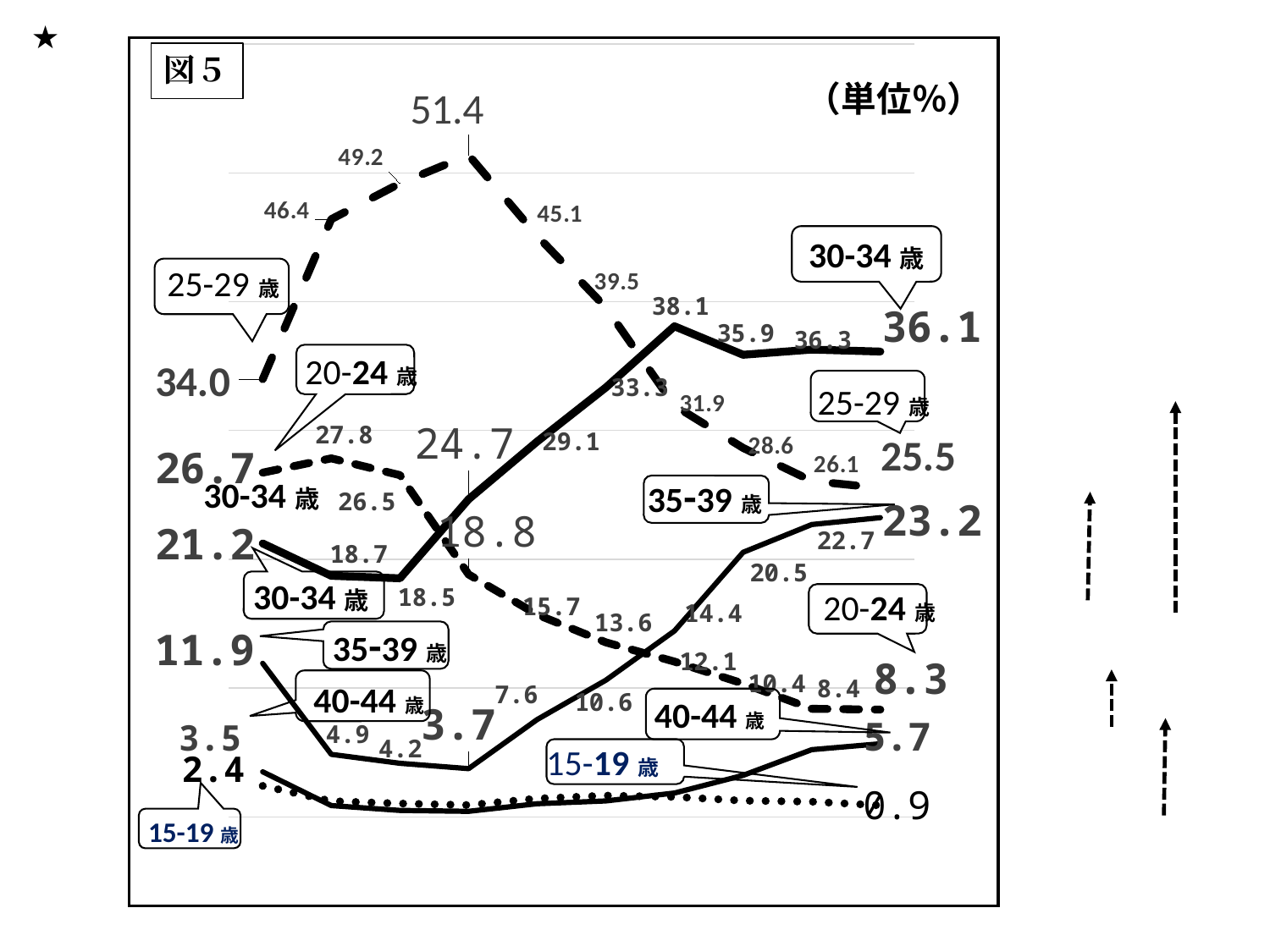
What is the difference between the final values of the 30-34歳 series (36.1) and the 25-29歳 series (25.5)? 10.6 What is the highest value printed on the chart, and which series does it belong to? 51.4, 25-29歳 What is the first (leftmost) value for the 25-29歳 series? 34.0 What unit is indicated in the top-right corner of the chart? % What kind of chart is shown in 図5? line chart Does the 20-24歳 series rise or fall overall from left to right? fall What is the final (rightmost) value for the 30-34歳 series? 36.1 What is the final (rightmost) value for the 15-19歳 series? 0.9 What is the final (rightmost) value for the 25-29歳 series? 25.5 What is the final (rightmost) value for the 20-24歳 series? 8.3 How many age-group series are plotted in 図5? 6 Which series has the highest value at the right end of the chart? 30-34歳